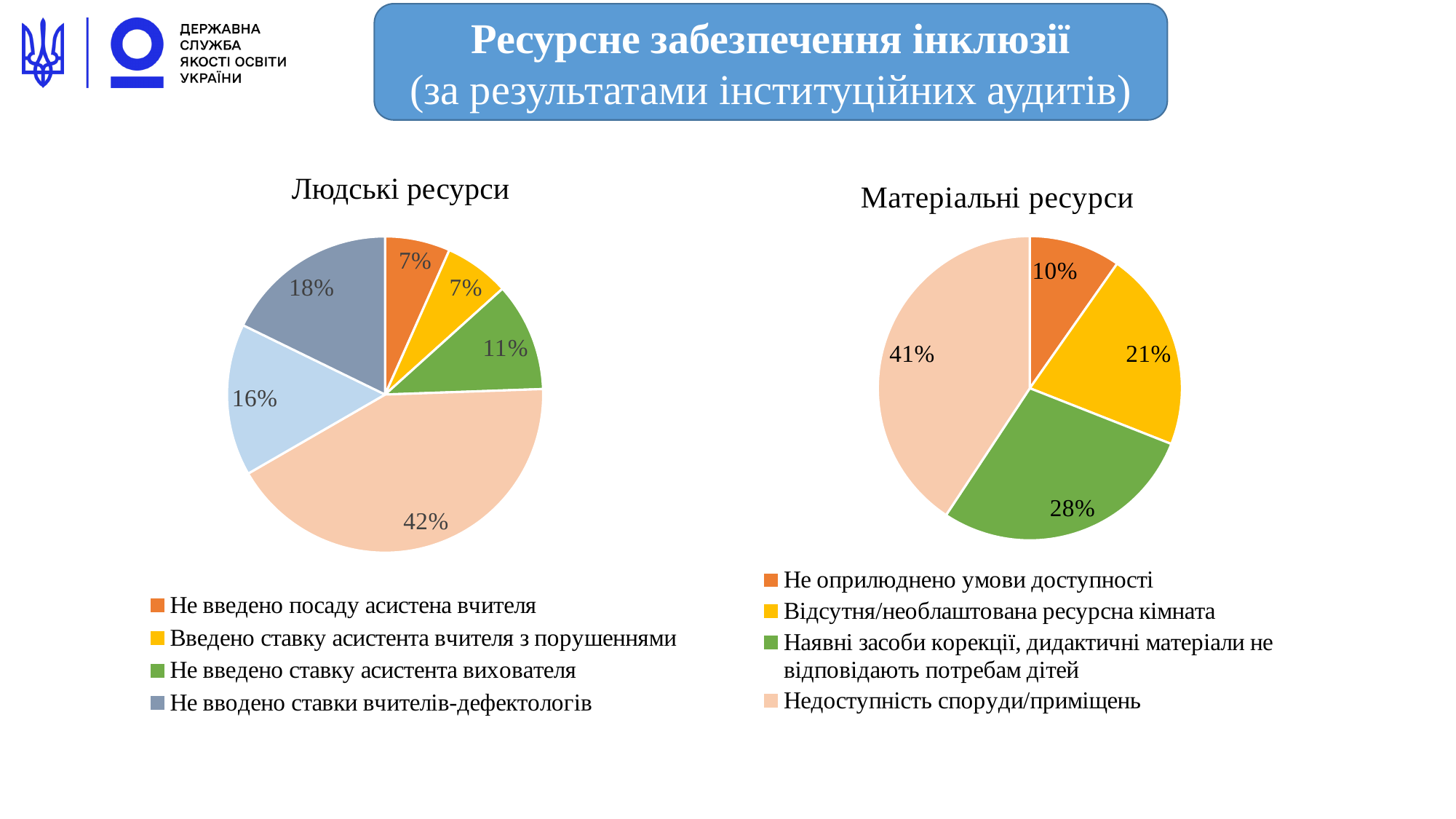
In the 'Матеріальні ресурси' chart, what share is shown for 'Недоступність споруди/приміщень'? 41% In the 'Людські ресурси' chart, what share is shown for 'Не введено ставку асистента вихователя'? 11% In the 'Людські ресурси' chart, what share is shown for 'Не вводено ставки вчителів-дефектологів'? 18% In the 'Людські ресурси' chart, what is the largest percentage shown on any slice? 42% In the 'Матеріальні ресурси' chart, which is larger: 'Відсутня/необлаштована ресурсна кімната' or 'Наявні засоби корекції, дидактичні матеріали не відповідають потребам дітей'? Наявні засоби корекції, дидактичні матеріали не відповідають потребам дітей In the 'Матеріальні ресурси' chart, what share is shown for 'Відсутня/необлаштована ресурсна кімната'? 21% In the 'Матеріальні ресурси' chart, which category has the smallest share? Не оприлюднено умови доступності What type of chart is the 'Людські ресурси' chart? Pie chart In the 'Матеріальні ресурси' chart, which category has the largest share? Недоступність споруди/приміщень In the 'Матеріальні ресурси' chart, what is the difference between the shares for 'Наявні засоби корекції, дидактичні матеріали не відповідають потребам дітей' and 'Відсутня/необлаштована ресурсна кімната'? 7% In the 'Матеріальні ресурси' chart, what share is shown for 'Не оприлюднено умови доступності'? 10% How many entries does the legend of the 'Матеріальні ресурси' chart list? 4